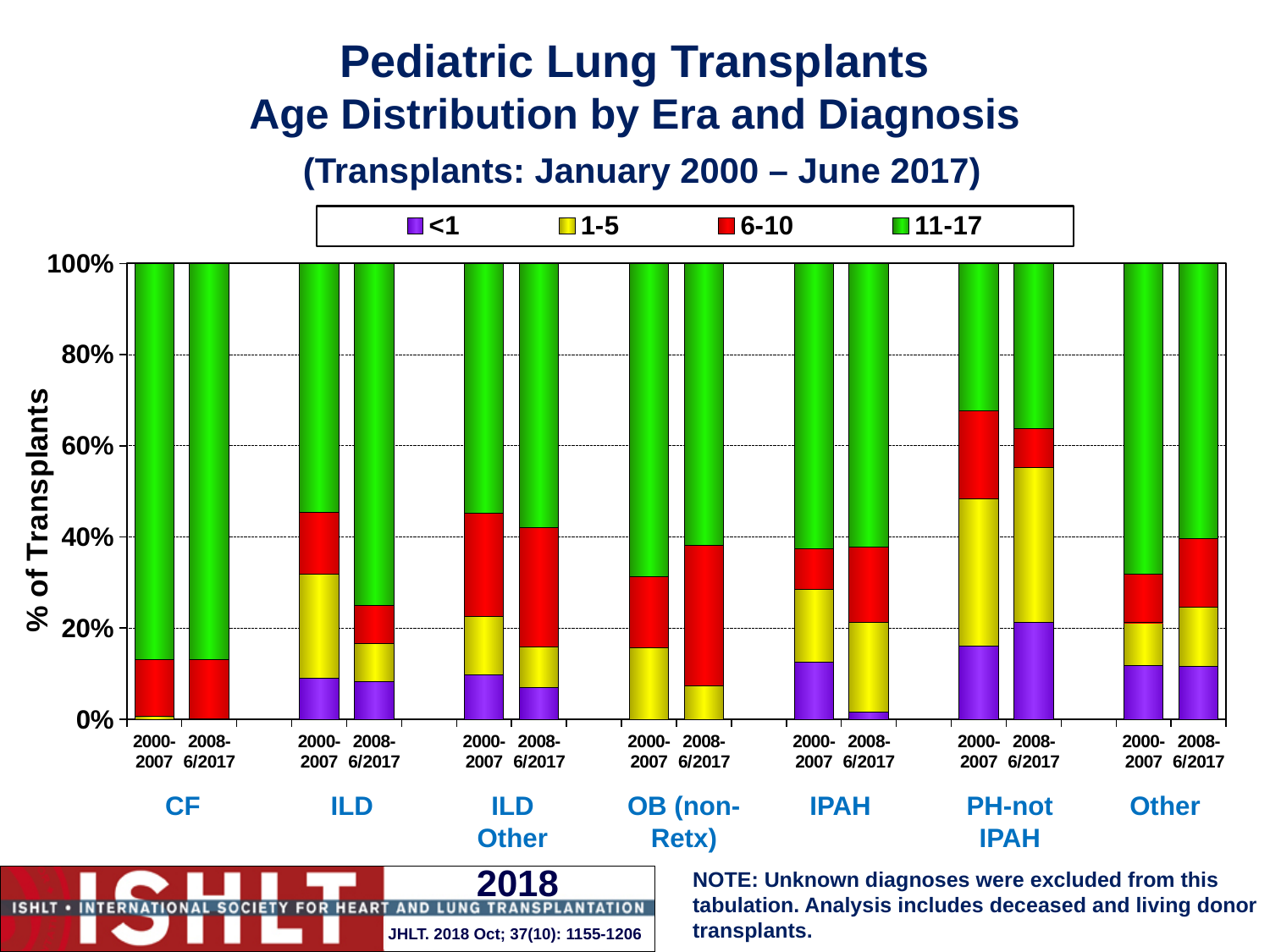
Which diagnosis has the largest 11-17 share in the 2000-2007 era? CF How many series does the legend list? 4 How many diagnosis groups are shown along the x axis? 7 In the PH-not IPAH 2000-2007 bar, is the combined share of ages under 11 (the top of the 6-10 segment) greater or less than 60%? greater Which bar has the largest <1 share in the chart? PH-not IPAH 2008-6/2017 Which diagnosis has the smallest 11-17 share in the 2000-2007 era? PH-not IPAH How many bars are plotted in the chart in total? 14 What are the four age groups listed in the legend? <1, 1-5, 6-10, 11-17 Is the 11-17 share for CF in 2000-2007 greater or less than 80%? greater What kind of chart is shown on the slide? Stacked bar chart For ILD, is the 11-17 share larger in 2000-2007 or in 2008-6/2017? 2008-6/2017 What is the label on the y axis? % of Transplants